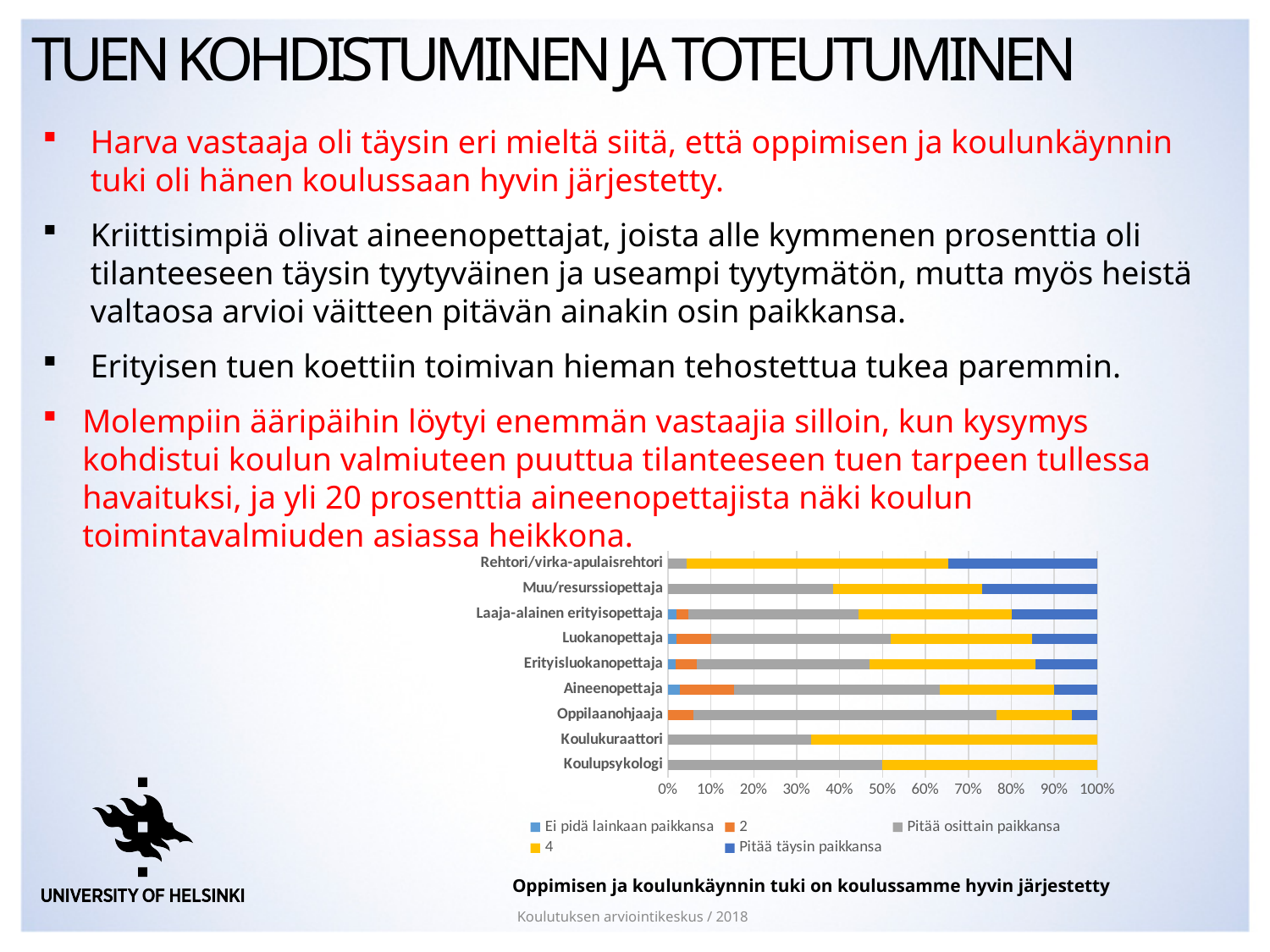
Is the 'Pitää osittain paikkansa' share for Koulukuraattori greater or less than 40%? less Is the 'Pitää osittain paikkansa' share for Koulupsykologi greater or less than 40%? greater Which category has the largest 'Pitää täysin paikkansa' share? Rehtori/virka-apulaisrehtori Is the 'Pitää täysin paikkansa' share for Aineenopettaja greater or less than 20%? less Which category has the largest '2' segment? Aineenopettaja What is the title of the chart? Oppimisen ja koulunkäynnin tuki on koulussamme hyvin järjestetty How many series does the chart legend list? 5 What kind of chart is shown on the slide? Stacked bar chart Is the 'Pitää täysin paikkansa' share larger for Rehtori/virka-apulaisrehtori or for Aineenopettaja? Rehtori/virka-apulaisrehtori How many respondent categories are listed on the vertical axis of the chart? 9 Which colour represents 'Pitää täysin paikkansa' in the chart legend? Blue